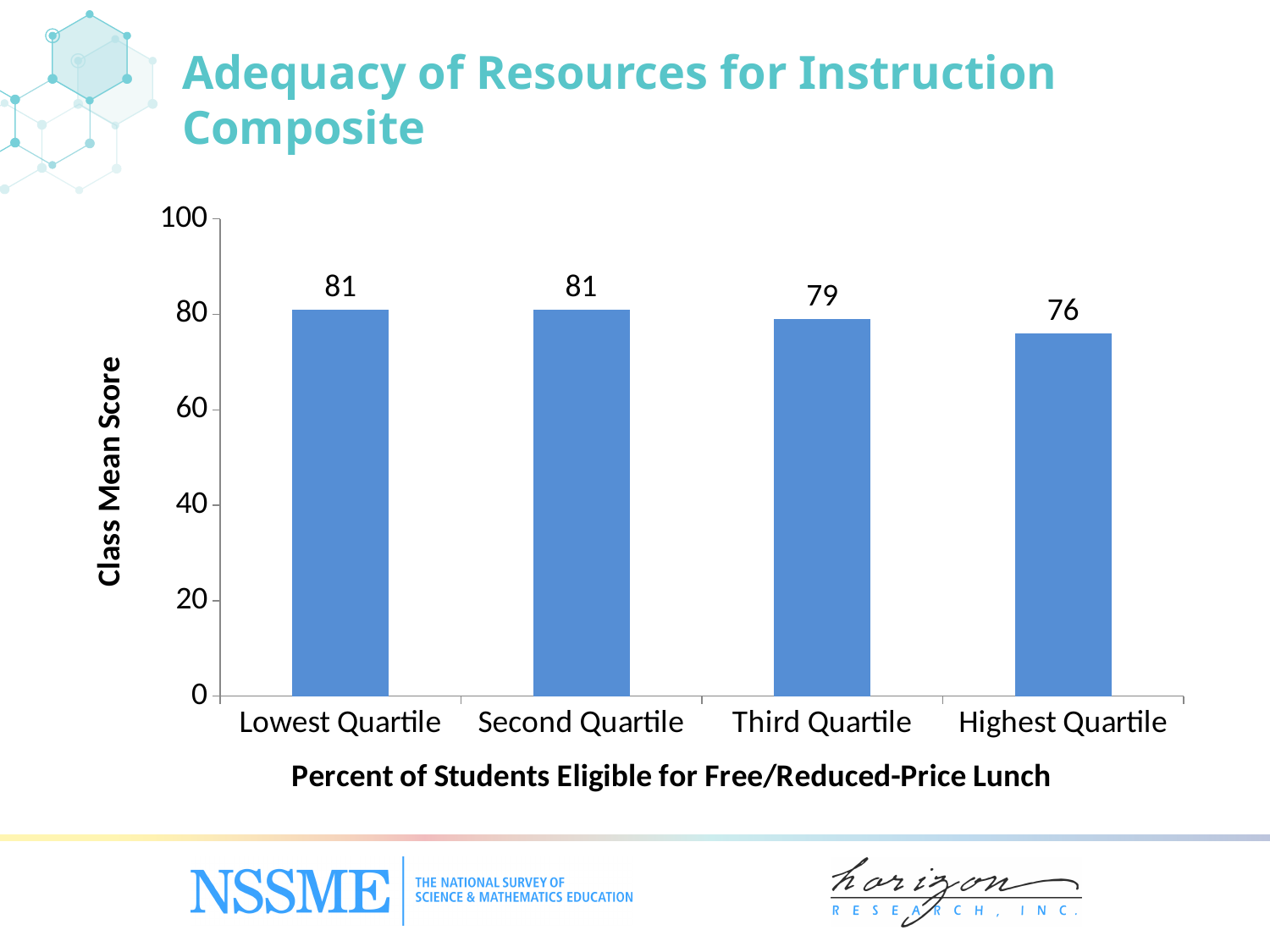
Which quartile has the lowest class mean score? Highest Quartile Do the class mean scores rise or fall from the Lowest Quartile to the Highest Quartile? fall What is the class mean score for the Lowest Quartile? 81 What is the class mean score for the Third Quartile? 79 What is the difference between the class mean scores for the Second Quartile and the Third Quartile? 2 Which has a larger class mean score, the Third Quartile or the Highest Quartile? Third Quartile Is the class mean score for the Highest Quartile greater or less than 80? less What is the difference between the class mean scores for the Lowest Quartile and the Highest Quartile? 5 What is the label of the y axis? Class Mean Score How many quartile categories are shown on the x axis? 4 What is the class mean score for the Highest Quartile? 76 What kind of chart is shown on the slide? bar chart